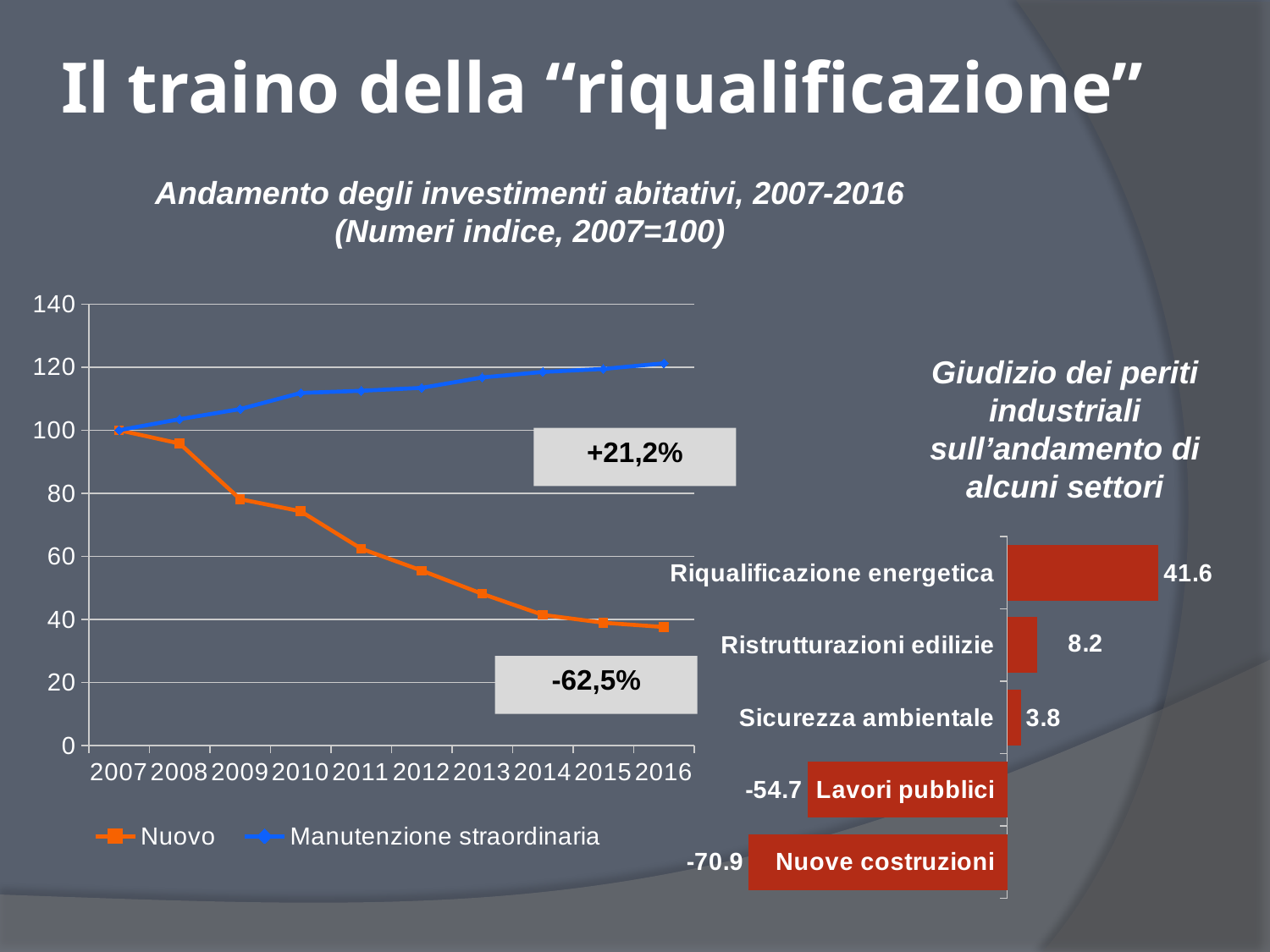
In the line chart 'Andamento degli investimenti abitativi, 2007-2016', is the value for Manutenzione straordinaria in 2010 greater or less than 100? greater In the bar chart 'Giudizio dei periti industriali sull'andamento di alcuni settori', what is the value for Lavori pubblici? -54.7 In the line chart 'Andamento degli investimenti abitativi, 2007-2016', does the Nuovo series rise or fall from 2007 to 2016? Fall In the bar chart 'Giudizio dei periti industriali sull'andamento di alcuni settori', which sector has the lowest value? Nuove costruzioni In the bar chart 'Giudizio dei periti industriali sull'andamento di alcuni settori', which sector has the highest value? Riqualificazione energetica In the bar chart 'Giudizio dei periti industriali sull'andamento di alcuni settori', what is the value for Riqualificazione energetica? 41.6 How many series does the legend of the line chart 'Andamento degli investimenti abitativi, 2007-2016' list? 2 What kind of chart is 'Andamento degli investimenti abitativi, 2007-2016'? Line chart In the bar chart 'Giudizio dei periti industriali sull'andamento di alcuni settori', what is the value for Nuove costruzioni? -70.9 How many sectors are shown in the bar chart 'Giudizio dei periti industriali sull'andamento di alcuni settori'? 5 In the bar chart 'Giudizio dei periti industriali sull'andamento di alcuni settori', which is larger: the value for Ristrutturazioni edilizie or Sicurezza ambientale? Ristrutturazioni edilizie In the bar chart 'Giudizio dei periti industriali sull'andamento di alcuni settori', what is the difference between the values for Ristrutturazioni edilizie and Sicurezza ambientale? 4.4